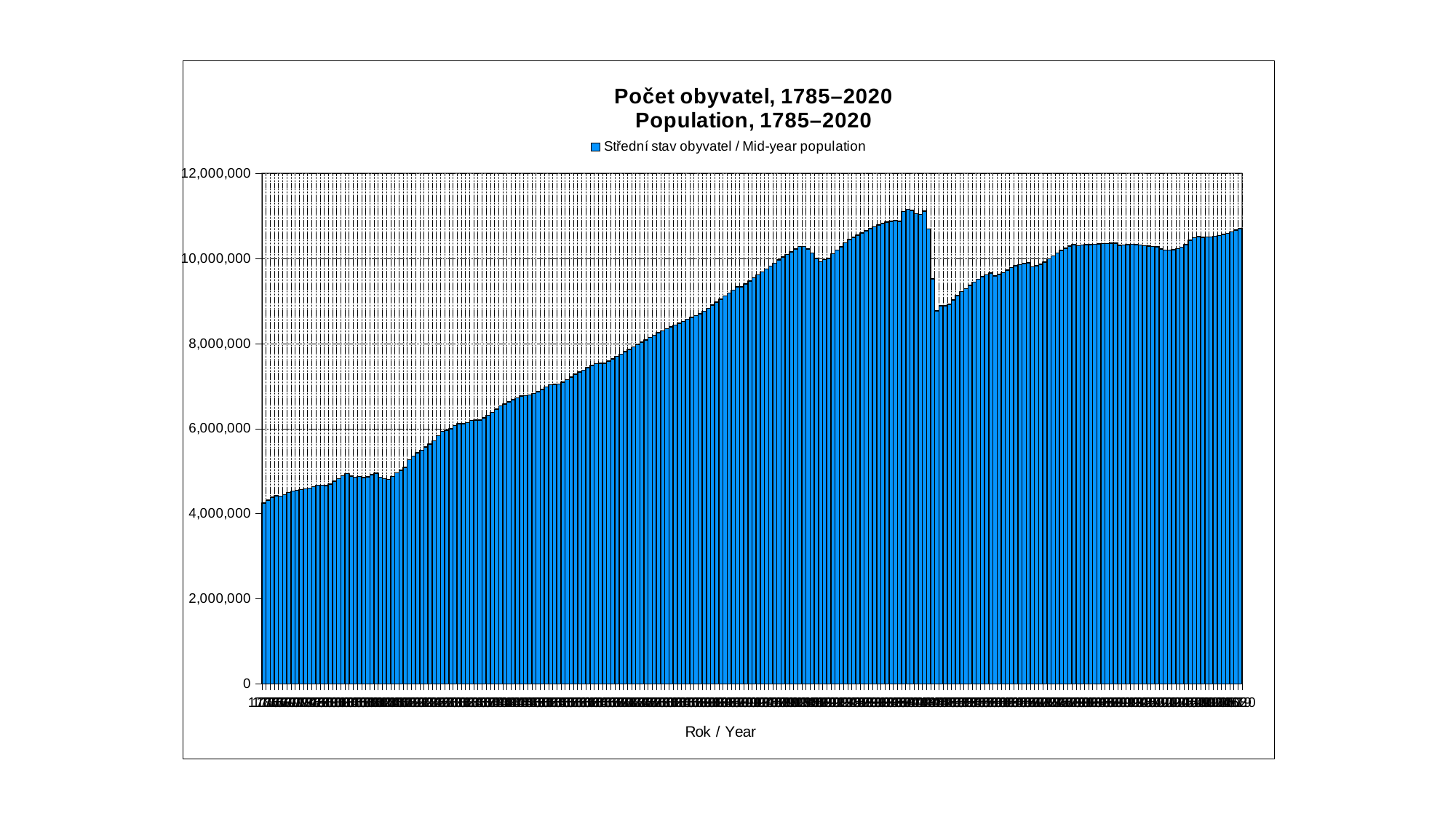
Is the value for the last year (2020) greater or less than 10,000,000? greater What is the legend entry for the series shown? Střední stav obyvatel / Mid-year population What is the highest tick value shown on the y axis? 12,000,000 Which year has the lower value, the first year (1785) or the last year (2020)? 1785 What is the title of the chart? Počet obyvatel, 1785–2020 Population, 1785–2020 Is the value for the first year (1785) greater or less than 4,000,000? greater How many series does the legend list? 1 How many years (bars) does the chart cover, from 1785 to 2020 inclusive? 236 Overall, do the values rise or fall from the first year to the last year along the x axis? rise Is the highest value in the chart greater or less than 12,000,000? less What kind of chart is shown on the slide? bar chart